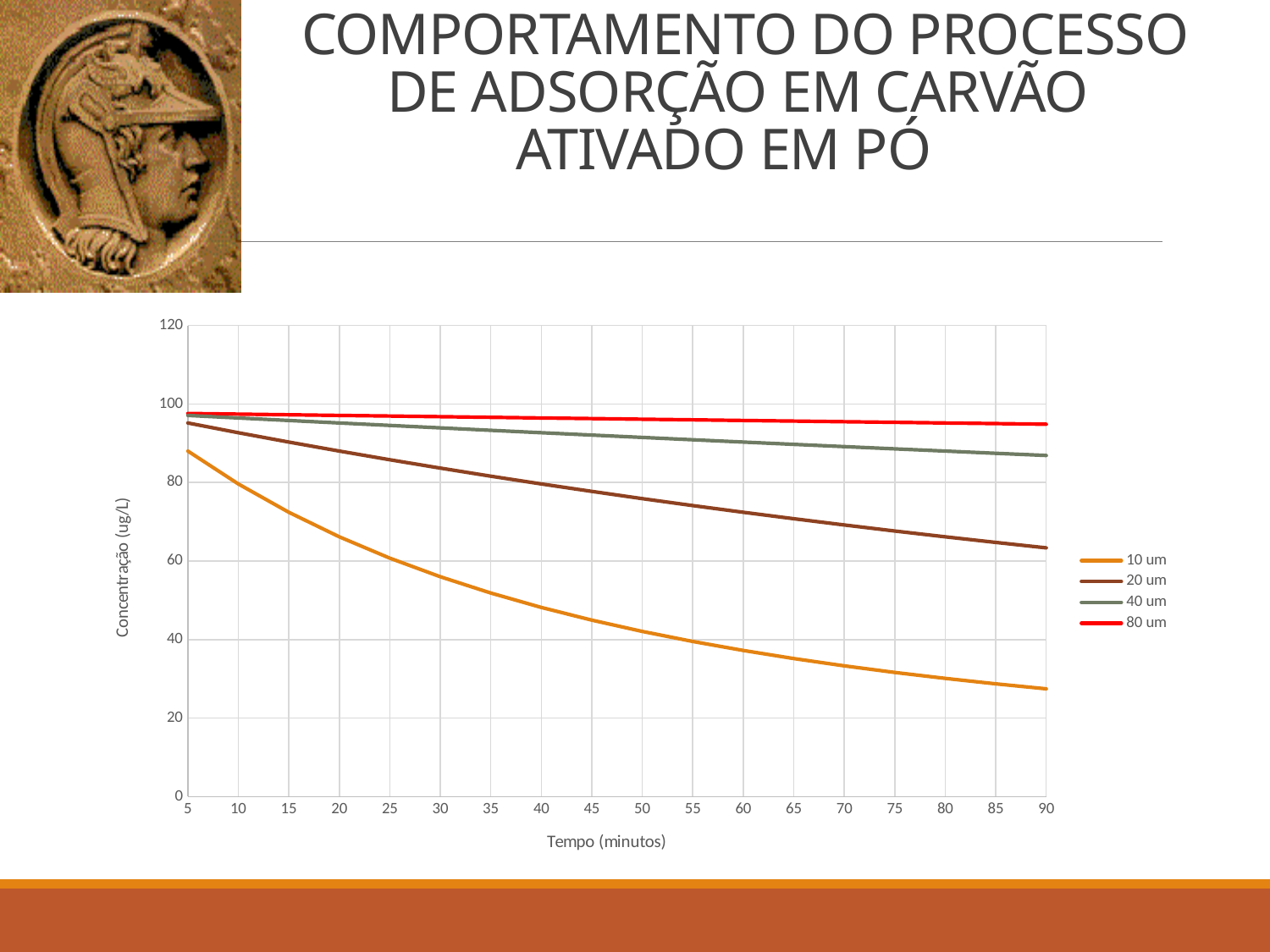
Does the concentration for the 10 um series rise or fall as time increases? fall At 90 minutes, which series has the larger concentration, 20 um or 40 um? 40 um What kind of chart is shown on the slide? line chart Is the concentration for the 20 um series at 90 minutes greater or less than 80? less Is the concentration for the 40 um series at 90 minutes greater or less than 80? greater Is the concentration for the 10 um series at 90 minutes greater or less than 40? less What are the series names listed in the legend? 10 um, 20 um, 40 um, 80 um Which series has the lowest concentration at 90 minutes? 10 um What is the label of the y axis? Concentração (ug/L) How many series does the legend list? 4 Which series has the highest concentration at 90 minutes? 80 um